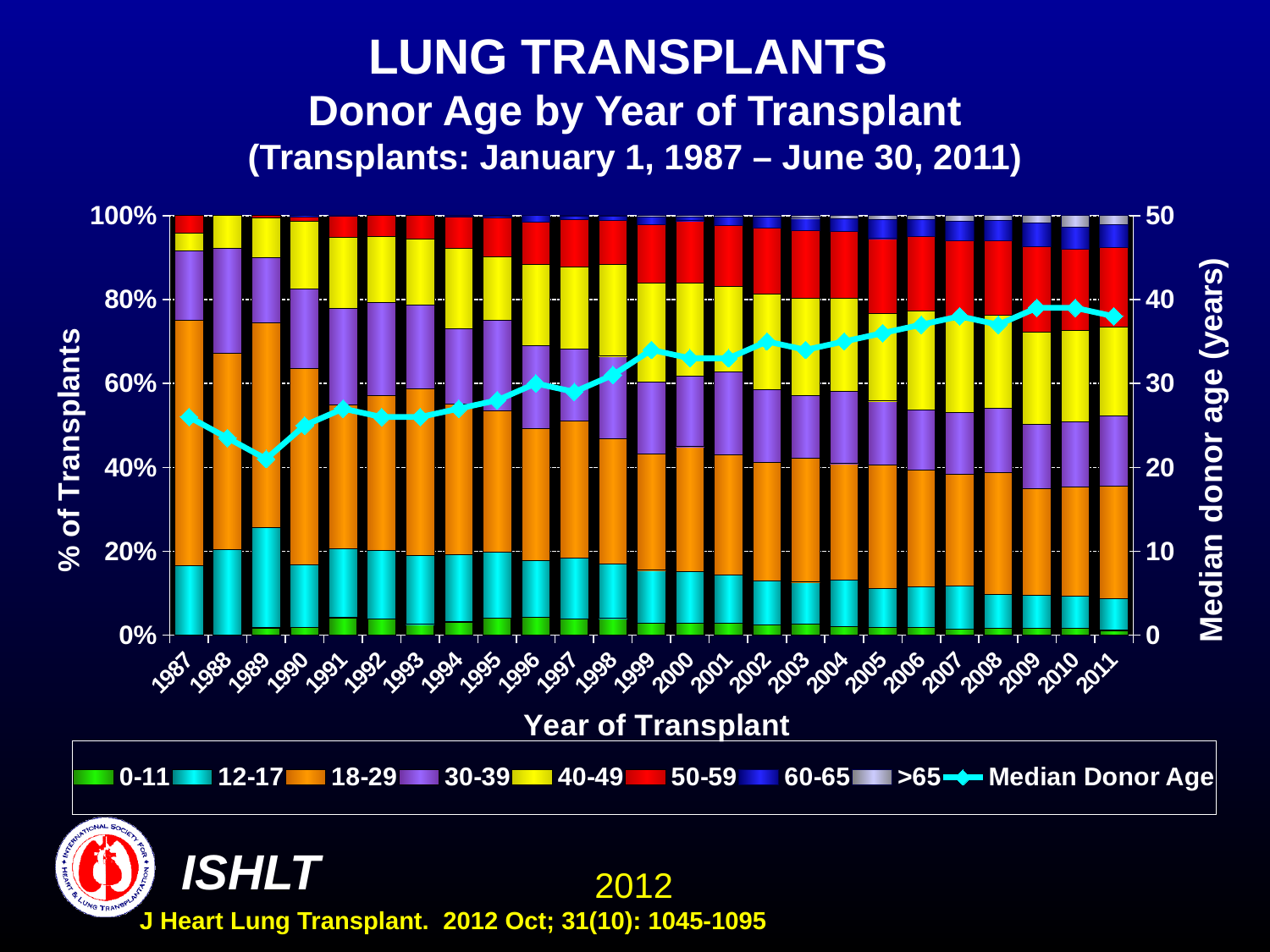
Is the Median Donor Age for 1987 greater or less than 30 years? less Which year has the higher Median Donor Age, 1989 or 2007? 2007 Is the Median Donor Age for 1989 greater or less than 30 years? less In which year is the Median Donor Age lowest? 1989 What is the label of the right-hand vertical axis? Median donor age (years) What kind of chart is shown on the slide? Stacked bar chart with a line Is the Median Donor Age for 2009 greater or less than 30 years? greater Does the Median Donor Age line generally rise or fall from 1987 to 2011? rise How many entries does the legend list? 9 What is the label of the x axis? Year of Transplant How many years are shown along the x axis of the chart? 25